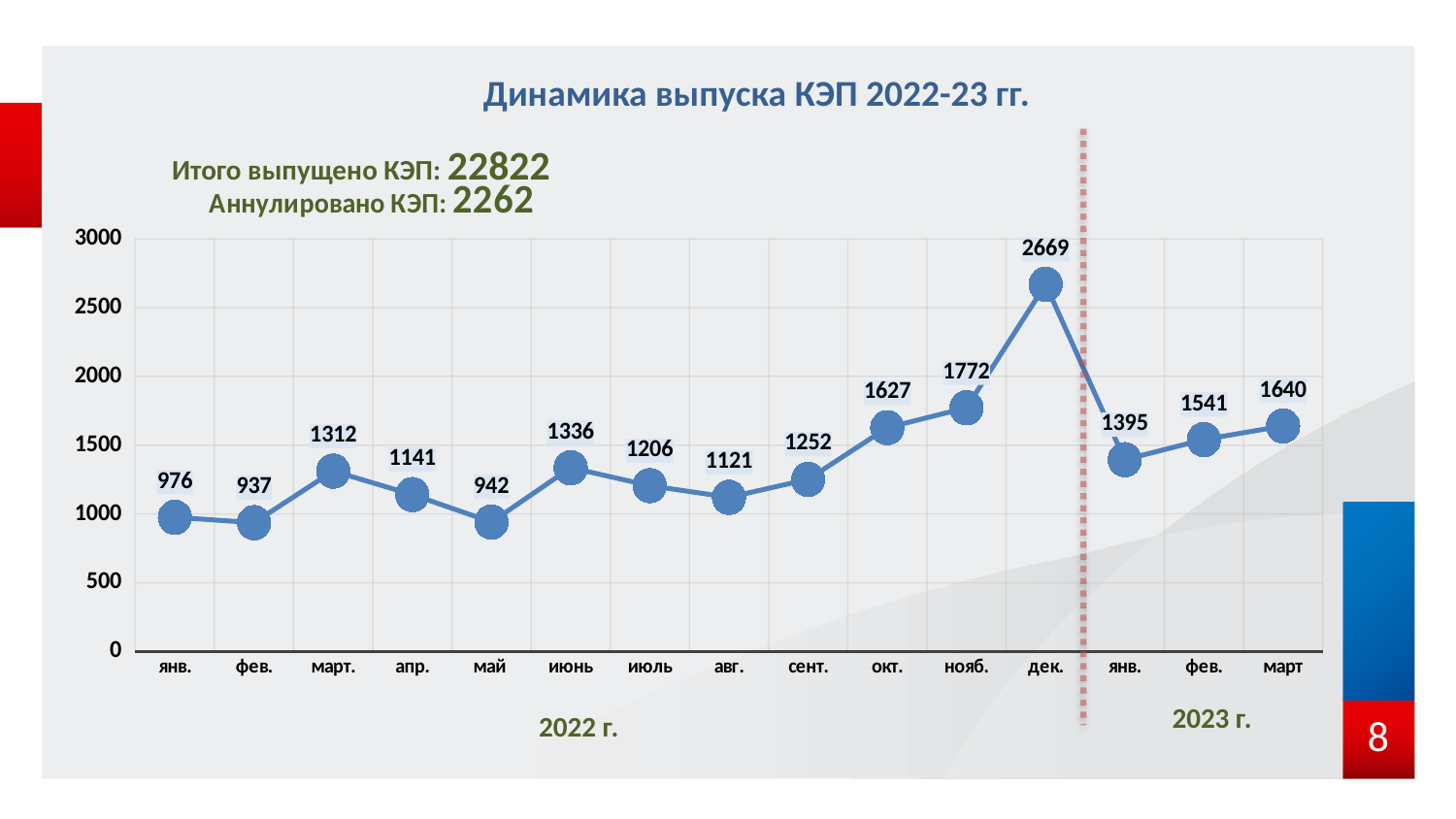
What is the value for дек. 2022? 2669 What is the value for март 2023? 1640 Do the values rise or fall from сент. 2022 to дек. 2022? rise Which month has the lowest value? фев. 2022 What is the difference between the values for дек. 2022 and янв. 2023? 1274 Which month has the highest value? дек. 2022 What is the title of the chart? Динамика выпуска КЭП 2022-23 гг. How many data points are plotted on the chart? 15 What is the difference between the values for фев. 2023 and янв. 2023? 146 What type of chart is shown on the slide? line chart What is the value for май 2022? 942 Which is larger, the value for окт. 2022 or the value for март 2023? март 2023